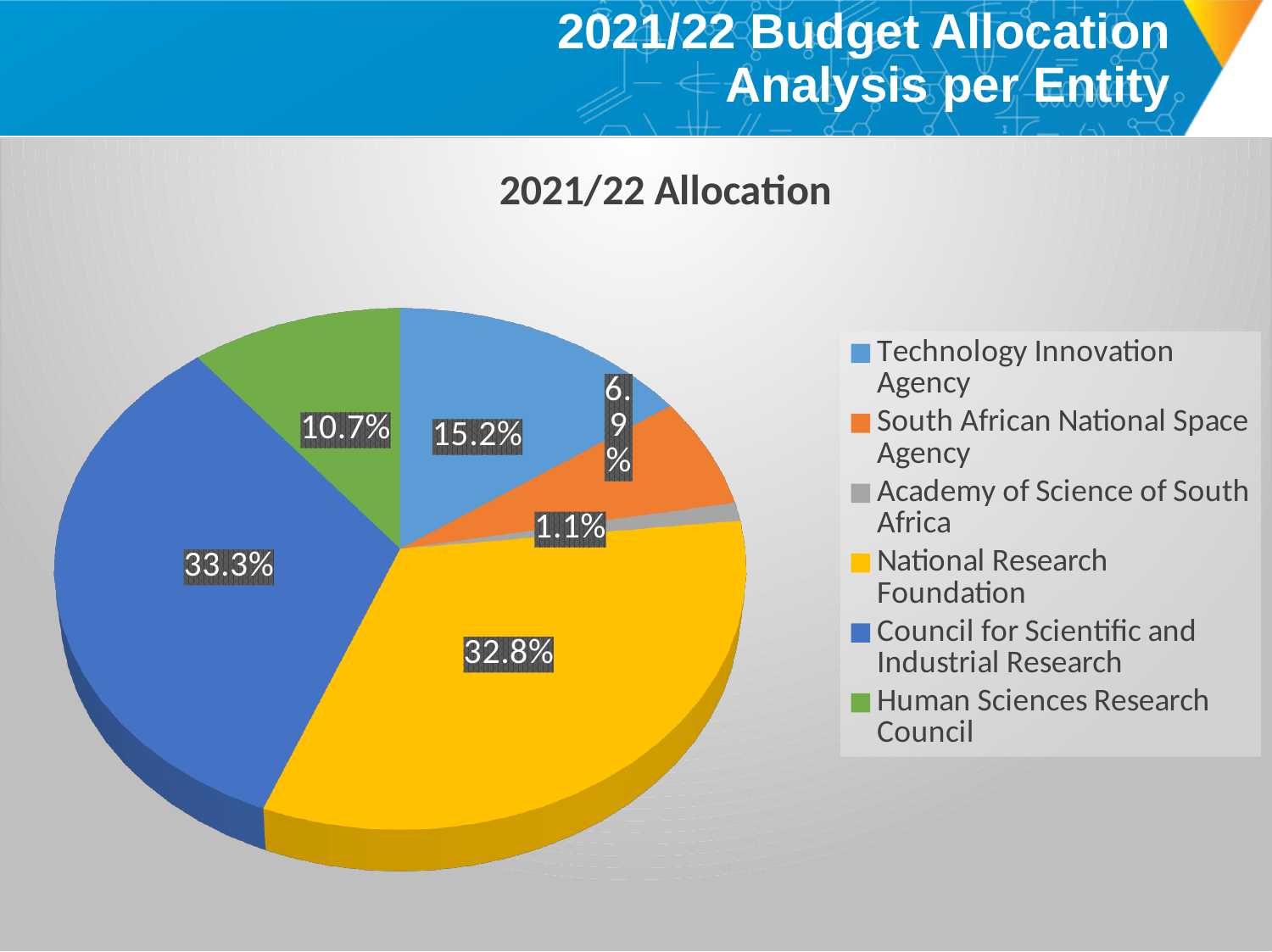
Which receives a larger share: the Technology Innovation Agency or the Human Sciences Research Council? Technology Innovation Agency Which entity receives the smallest share of the 2021/22 allocation? Academy of Science of South Africa How many entities are shown in the pie chart? 6 Which entity receives the largest share of the 2021/22 allocation? Council for Scientific and Industrial Research What share of the 2021/22 allocation goes to the National Research Foundation? 32.8% What is the title of the chart? 2021/22 Allocation What share of the 2021/22 allocation goes to the Academy of Science of South Africa? 1.1% What is the difference in percentage points between the Council for Scientific and Industrial Research share and the National Research Foundation share? 0.5 percentage points What share of the 2021/22 allocation goes to the Technology Innovation Agency? 15.2% What type of chart is shown on the slide? Pie chart What share of the 2021/22 allocation goes to the Human Sciences Research Council? 10.7% What share of the 2021/22 allocation goes to the Council for Scientific and Industrial Research? 33.3%